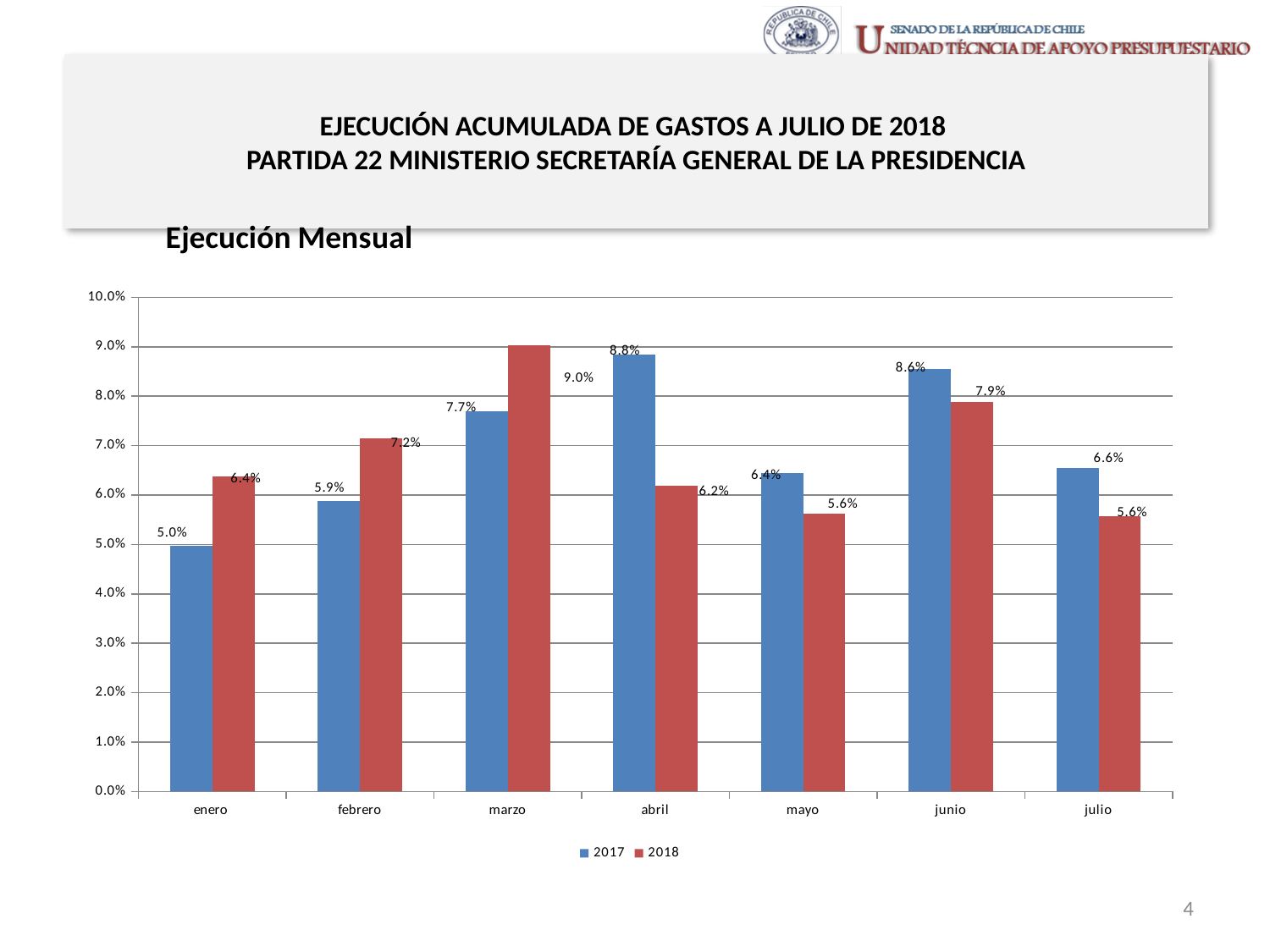
Is the value for 2017 in junio greater or less than 8.0%? greater What is the difference between the 2018 and 2017 values in abril? 2.6 percentage points Which month has the lowest value for the 2017 series? enero How many series does the legend list? 2 What is the value for 2018 in junio? 7.9% Does the 2018 series rise or fall from enero to marzo? rise In mayo, which series has the larger value, 2017 or 2018? 2017 What kind of chart is shown on the slide? bar chart Which month has the highest value for the 2018 series? marzo What is the value for 2018 in marzo? 9.0% How many months are shown on the x axis? 7 What is the value for 2017 in enero? 5.0%